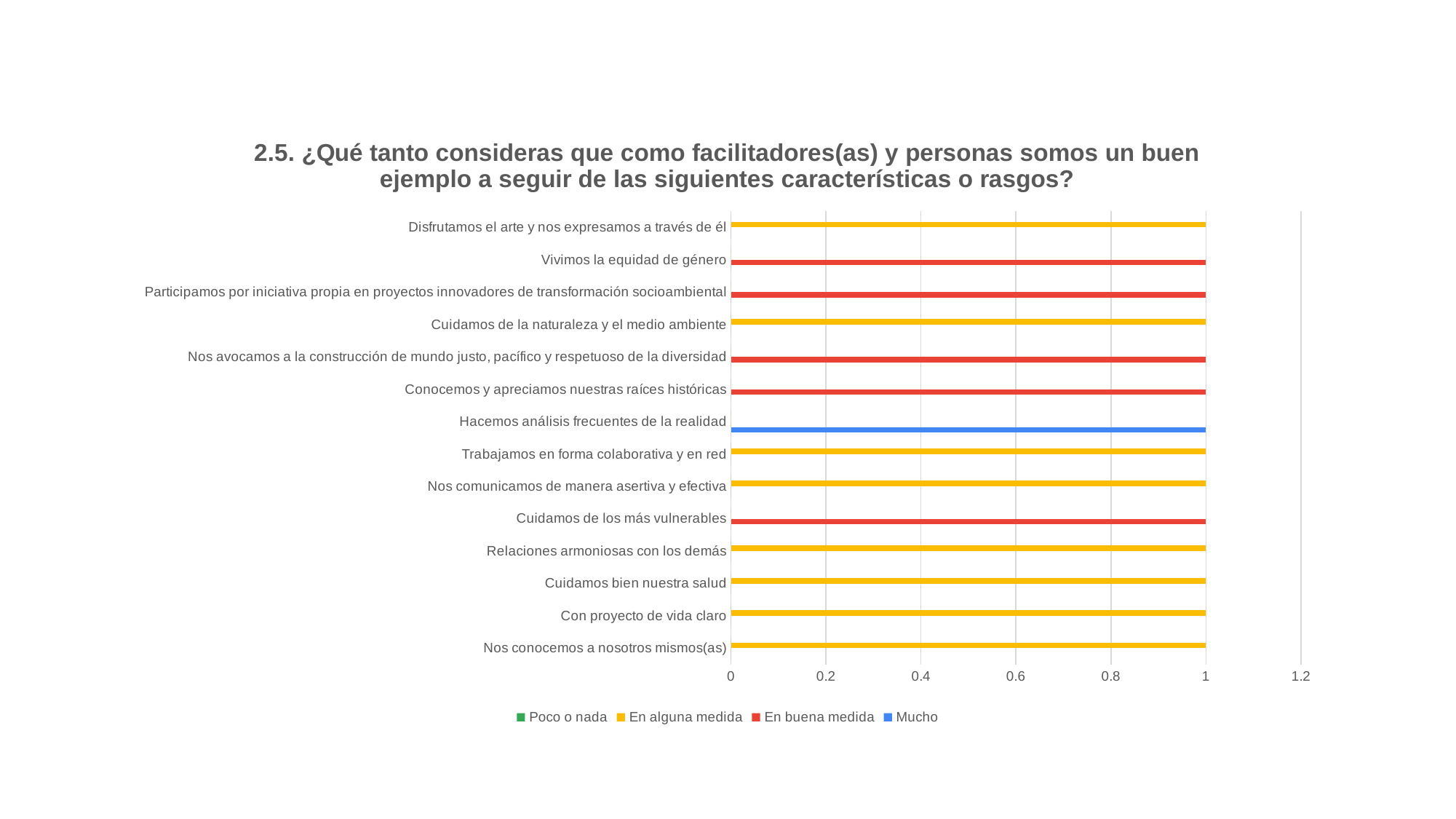
Which series does the bar for "Hacemos análisis frecuentes de la realidad" belong to? Mucho Which series does the bar for "Participamos por iniciativa propia en proyectos innovadores de transformación socioambiental" belong to? En buena medida What is the highest tick value shown on the horizontal axis? 1.2 What is the value of the bar for "Hacemos análisis frecuentes de la realidad"? 1 Is the value for "Cuidamos de los más vulnerables" greater or less than 0.8? greater How many series does the legend list? 4 What is the value of the bar for "Vivimos la equidad de género"? 1 What is the value of the bar for "Nos conocemos a nosotros mismos(as)"? 1 How many categories are listed on the vertical axis of the chart? 14 What kind of chart is shown on the slide? bar chart How many categories have a bar in the "En buena medida" series? 5 Is the value for "Con proyecto de vida claro" greater or less than 0.6? greater